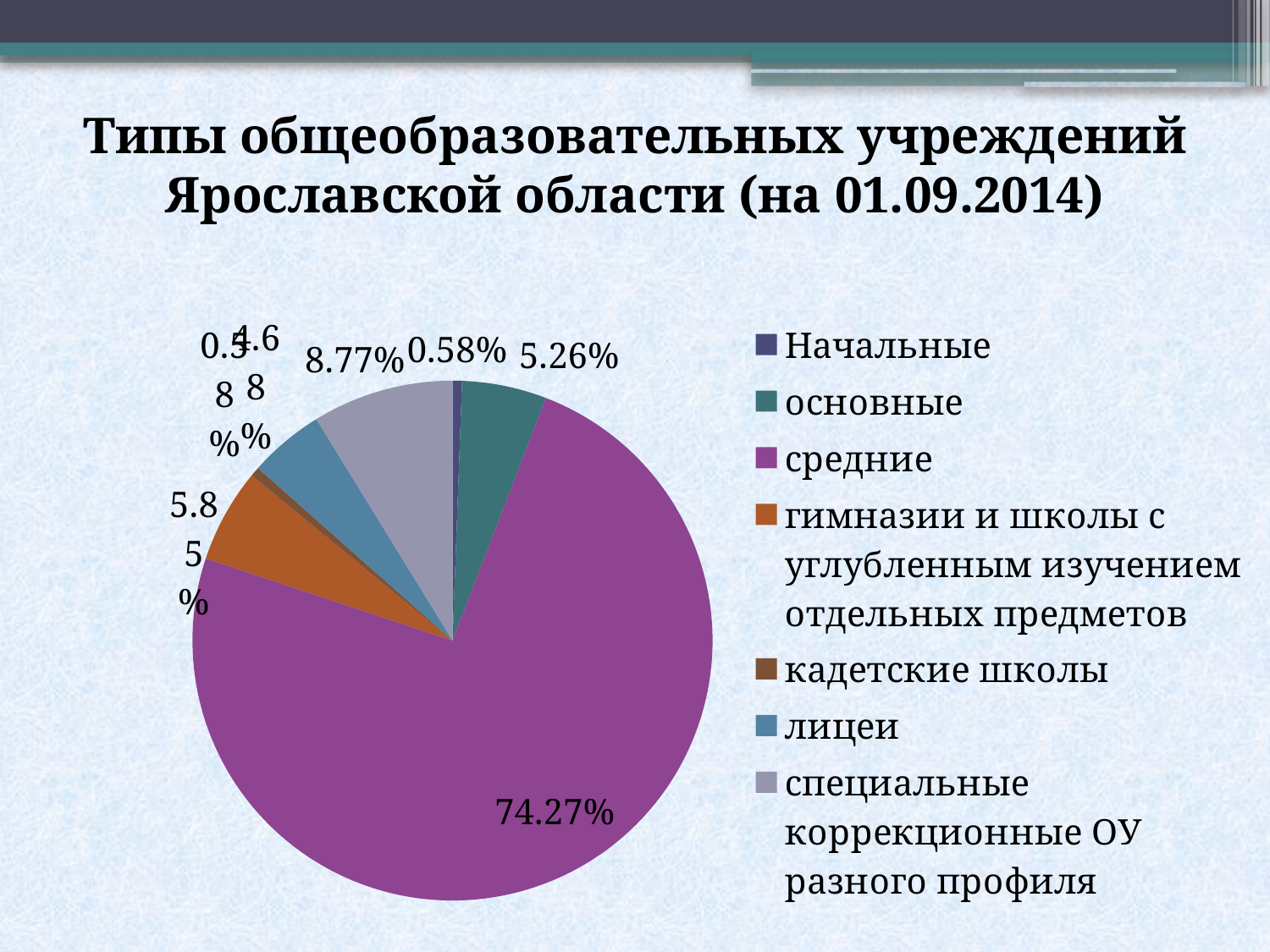
Which is larger: the slice for основные or the slice for специальные коррекционные ОУ разного профиля? специальные коррекционные ОУ разного профиля What type of chart is shown on the slide? pie chart What colour is the slice for средние? purple What percentage is shown for Начальные? 0.58% What is the difference between the share for средние and the share for специальные коррекционные ОУ разного профиля? 65.50% How many categories does the legend list? 7 What share of the pie is labelled for средние? 74.27% What percentage is shown for специальные коррекционные ОУ разного профиля? 8.77% What percentage is shown for гимназии и школы с углубленным изучением отдельных предметов? 5.85% What is the title of the chart? Типы общеобразовательных учреждений Ярославской области (на 01.09.2014) What percentage is shown for основные? 5.26% Which category has the largest slice of the pie? средние